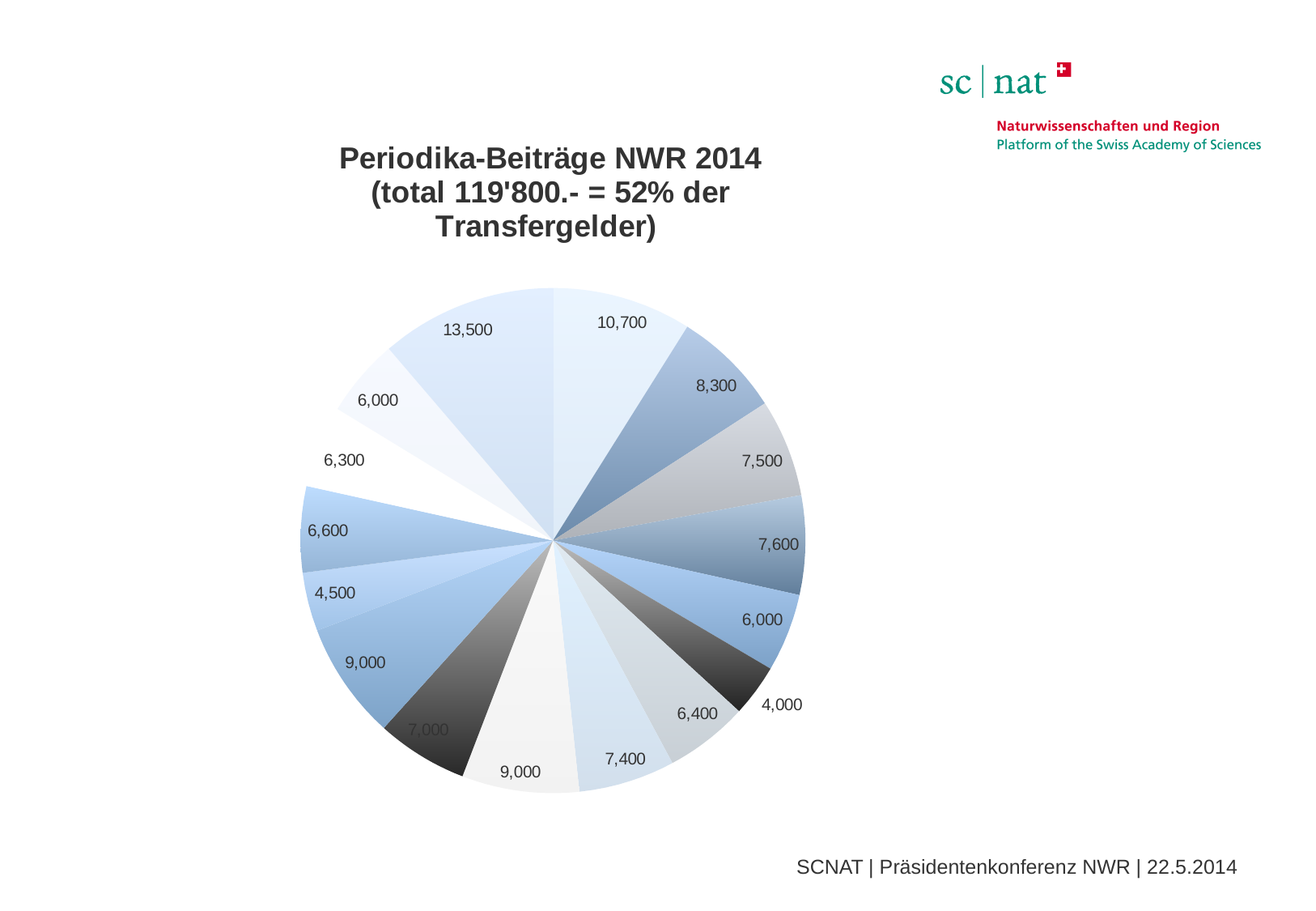
What share of the total 119'800 does the largest slice (13,500) represent? 11.3% According to the chart title, what percentage of the Transfergelder do the Periodika-Beiträge represent? 52% What is the title of the chart? Periodika-Beiträge NWR 2014 (total 119'800.- = 52% der Transfergelder) How many slices in the pie chart are labelled 9,000? 2 How many slices in the pie chart are labelled 6,000? 2 What is the difference between the largest slice (13,500) and the smallest slice (4,000)? 9,500 What total is stated in the chart title? 119'800.- How many slices does the pie chart have? 16 Which is larger, the slice labelled 10,700 or the slice labelled 8,300? 10,700 What kind of chart is shown on the slide? pie chart What is the value of the largest slice in the pie chart? 13,500 What is the value of the smallest slice in the pie chart? 4,000